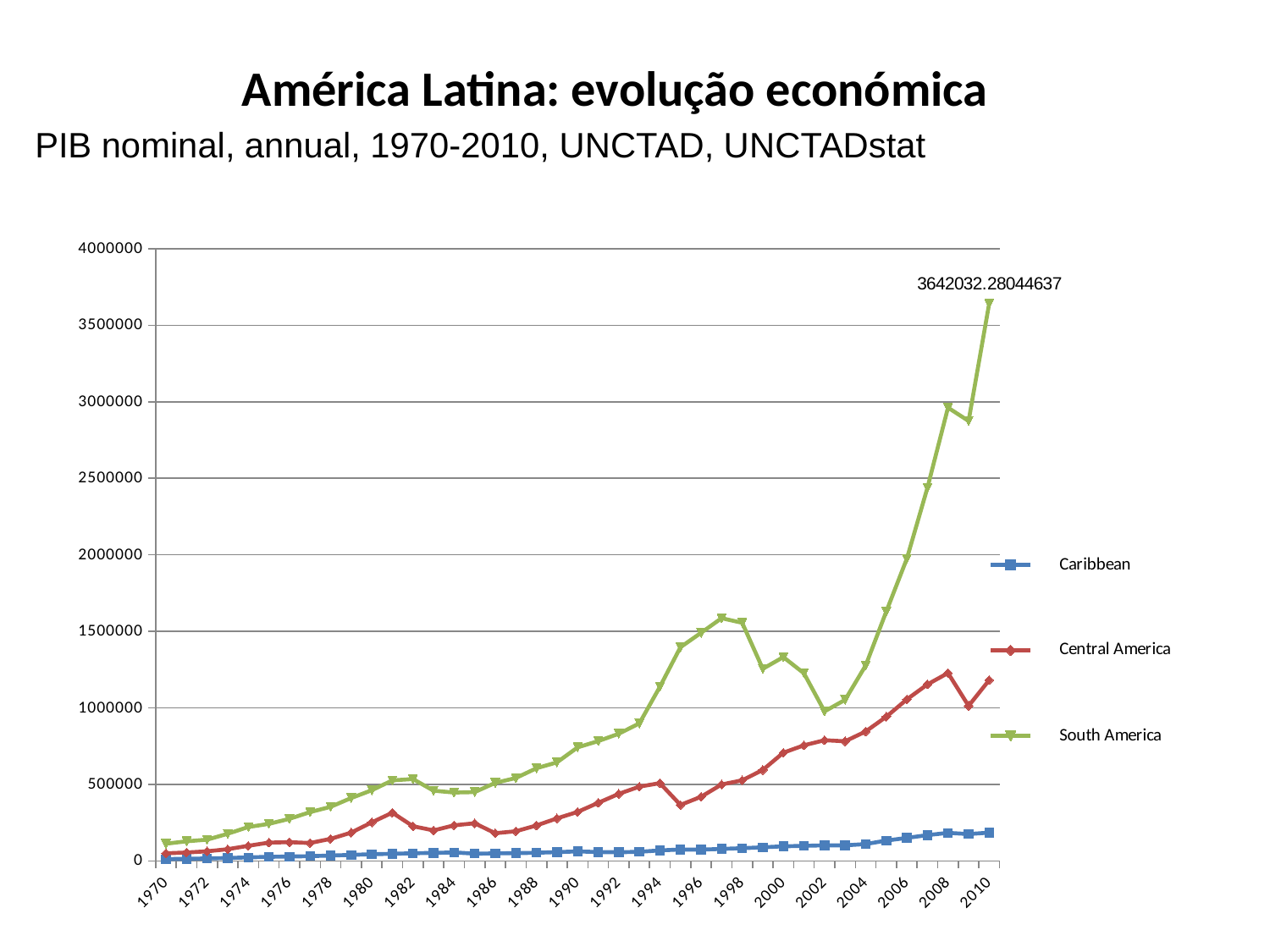
Which series has the highest value in 2010? South America What is the labelled value for South America in 2010? 3642032.28044637 Is the value for Central America in 2010 greater or less than 1500000? less Is the value for Caribbean in 2010 greater or less than 500000? less Which is larger in 2000, Central America or Caribbean? Central America What is the title of the slide? América Latina: evolução económica Which series has the lowest value in 2010? Caribbean Does the South America series overall rise or fall from 1970 to 2010? rise What kind of chart is shown on the slide? line chart How many series does the legend list? 3 Is the value for South America in 2010 greater or less than 3500000? greater